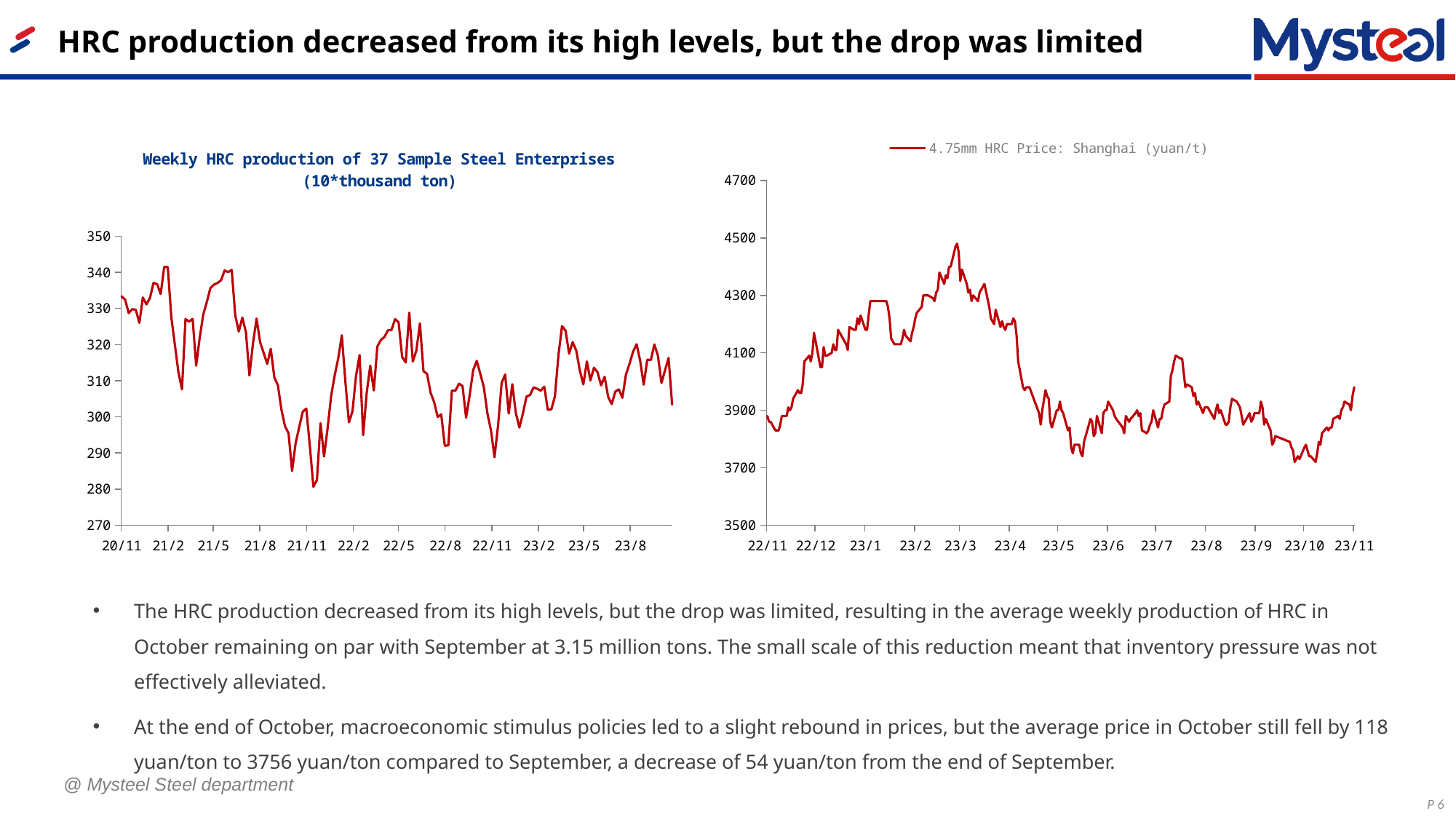
In the left chart (Weekly HRC production), is the highest point of the series, around 21/2, greater or less than 330? greater What kind of chart is the right chart on the slide? Line chart In the right chart (4.75mm HRC Price: Shanghai), is the lowest value around 23/10 greater or less than 3900? less What is the title of the left chart? Weekly HRC production of 37 Sample Steel Enterprises (10*thousand ton) In the left chart (Weekly HRC production), is the lowest point of the series, around 21/11, greater or less than 290? less What series does the legend of the right chart list? 4.75mm HRC Price: Shanghai (yuan/t) In the right chart (4.75mm HRC Price: Shanghai), does the price rise or fall between 23/10 and 23/11? rise How many series does the legend of the right chart list? 1 What kind of chart is the left chart on the slide? Line chart In the right chart (4.75mm HRC Price: Shanghai), does the price rise or fall between 23/3 and 23/5? fall